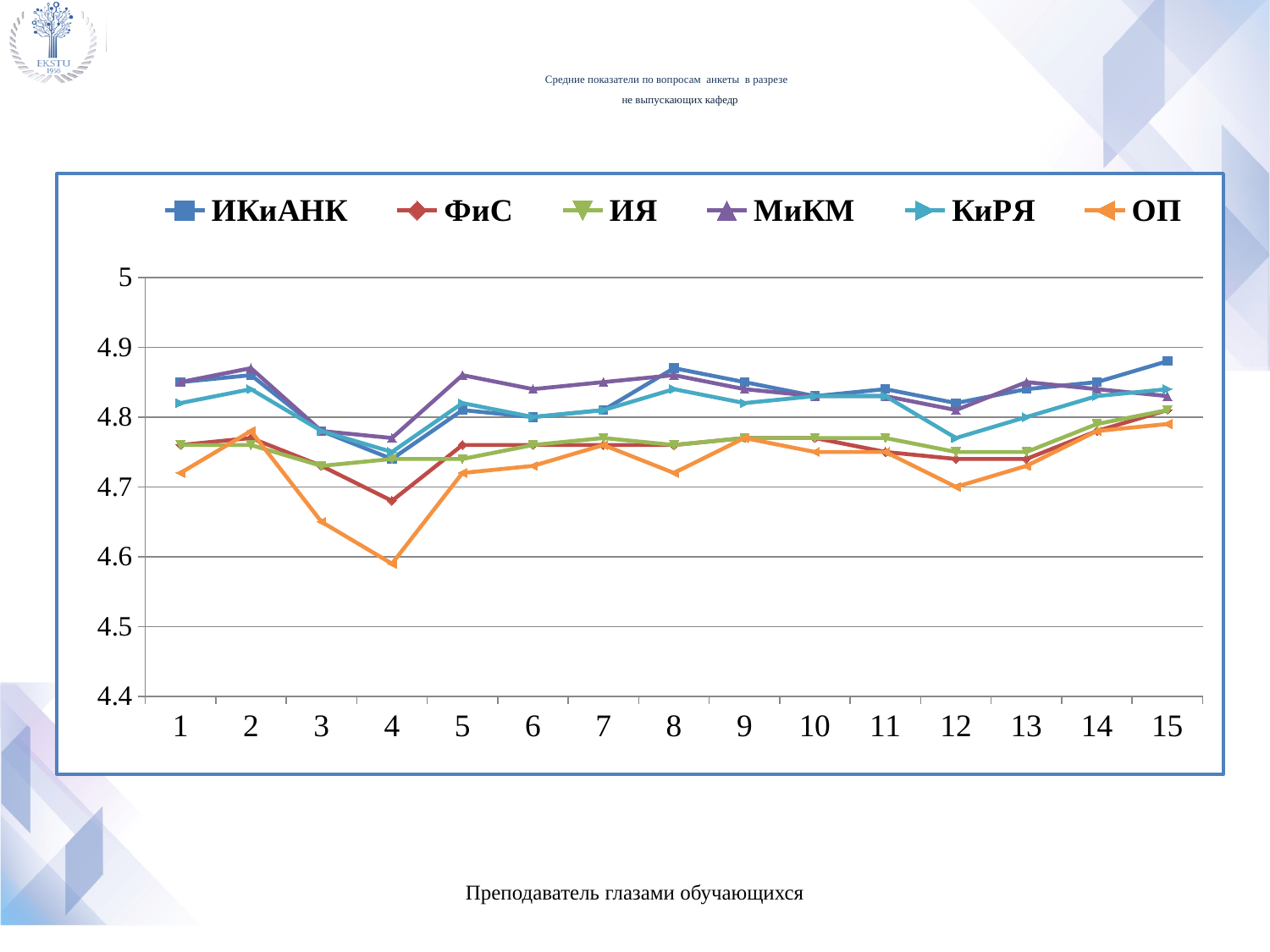
At point 4, which series has the higher value, МиКМ or ОП? МиКМ Is the value for ОП at point 4 greater or less than 4.7? less Is the value for ИЯ at point 1 greater or less than 4.8? less Is the value for МиКМ at point 5 greater or less than 4.8? greater Which series has the highest value at point 15? ИКиАНК What kind of chart is shown on the slide? line chart How many series does the legend list? 6 Which series has the lowest value at point 4? ОП Which series is shown in orange in the legend? ОП At which x-axis point does the ОП series reach its lowest value? 4 How many points are there along the x axis? 15